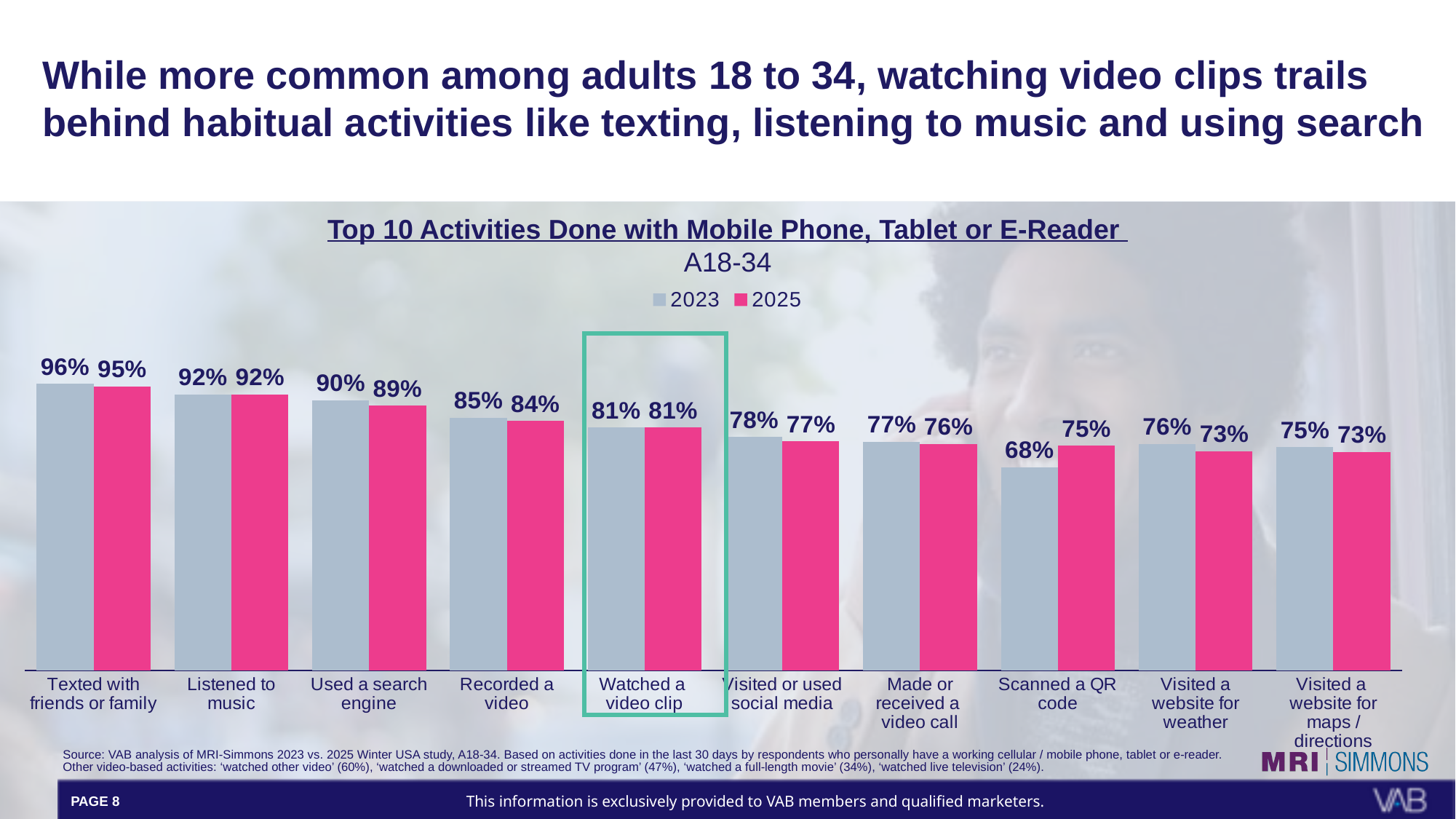
How many activities are shown on the chart? 10 Which activity has the lowest 2023 value? Scanned a QR code What is the difference between the 2023 and 2025 values for 'Scanned a QR code'? 7 percentage points What was the 2023 value for 'Scanned a QR code'? 68% Which is larger: the 2025 value for 'Visited a website for weather' or the 2025 value for 'Scanned a QR code'? Scanned a QR code Which activity is highlighted with a green box on the chart? Watched a video clip What was the 2025 value for 'Watched a video clip'? 81% Which activity has the highest 2023 value? Texted with friends or family What was the 2025 value for 'Texted with friends or family'? 95% How many series does the legend list? 2 What kind of chart is shown on the slide? Bar chart What is the difference between the 2025 values for 'Listened to music' and 'Watched a video clip'? 11 percentage points